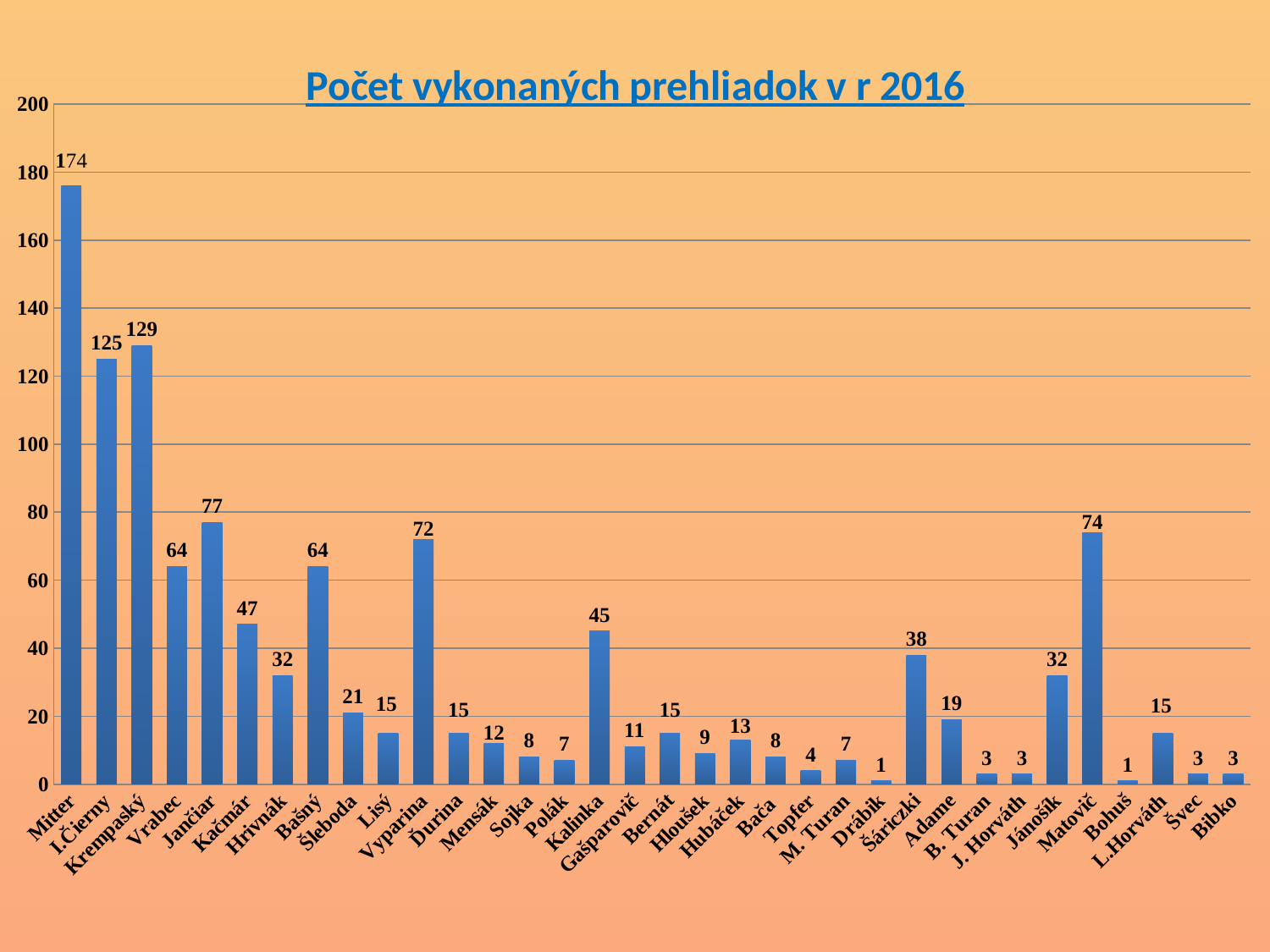
What is the difference between the values for Mitter and I.Čierny? 49 What is the difference between the values for Jančiar and Vyparina? 5 Which category has the highest value? Mitter What is the title of the chart? Počet vykonaných prehliadok v r 2016 What is the value for Krempaský? 129 What is the value for Mitter? 174 What is the value for Šáriczki? 38 What is the value for Matovič? 74 What kind of chart is shown on the slide? bar chart Which is larger, the value for Kalinka or the value for Kačmár? Kačmár Is the value for Jančiar greater or less than 60? greater How many categories are shown on the x axis? 34